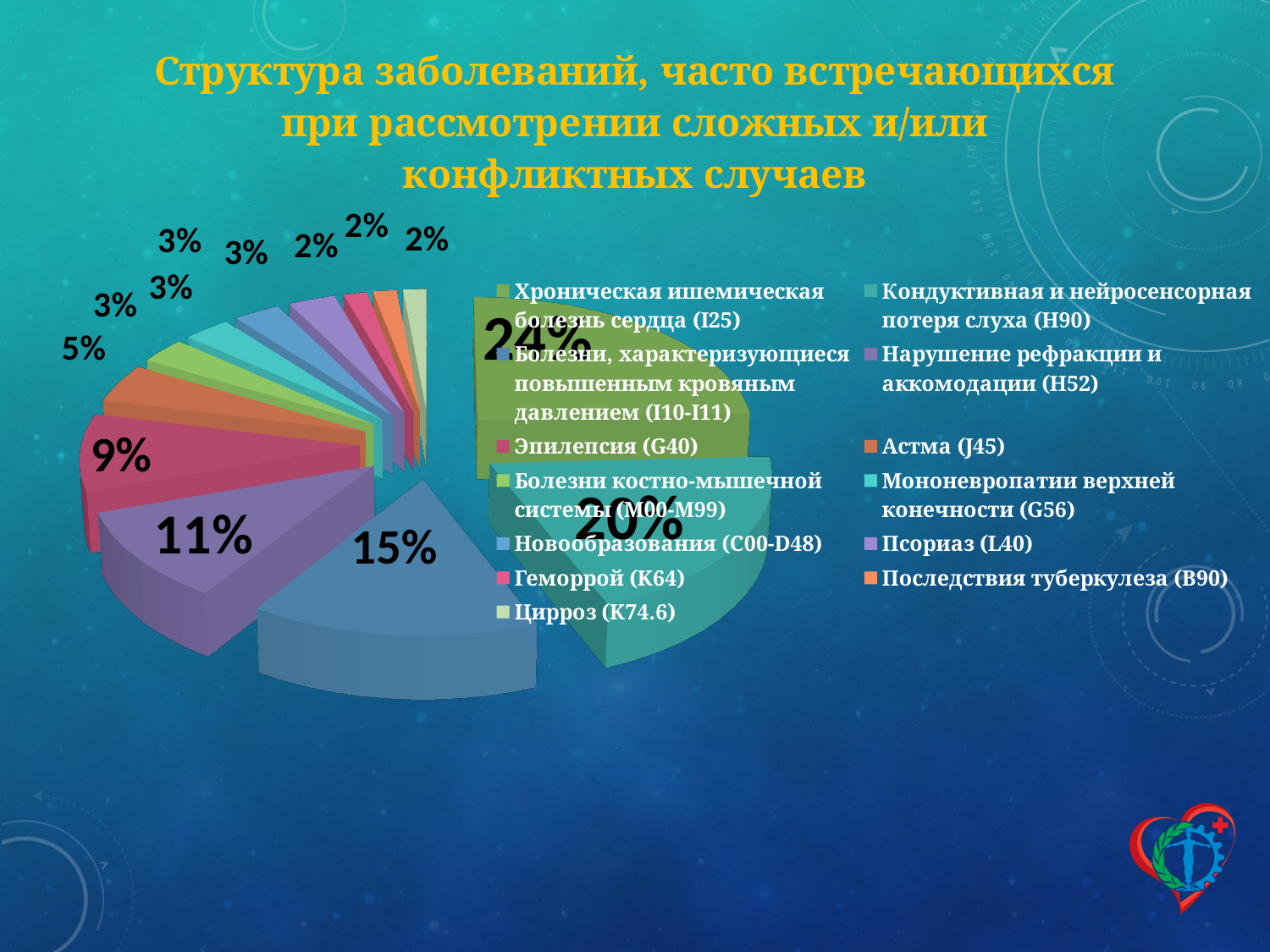
What share of the pie does Хроническая ишемическая болезнь сердца (I25) have? 24% What is the combined share of the two largest slices (24% and 20%)? 44% What is the title of the slide? Структура заболеваний, часто встречающихся при рассмотрении сложных и/или конфликтных случаев What is the difference in percentage points between the 24% slice and the 20% slice? 4 How many slices are labelled 3%? 4 Which is larger: the slice for Хроническая ишемическая болезнь сердца (I25) or the slice for Болезни, характеризующиеся повышенным кровяным давлением (I10-I11)? Хроническая ишемическая болезнь сердца (I25) Which category has the largest slice of the pie? Хроническая ишемическая болезнь сердца (I25) What is the smallest percentage shown on the pie chart? 2% How many categories does the legend list? 13 What is the largest percentage shown on the pie chart? 24% What kind of chart is shown on the slide? pie chart What share of the pie does Болезни, характеризующиеся повышенным кровяным давлением (I10-I11) have? 15%